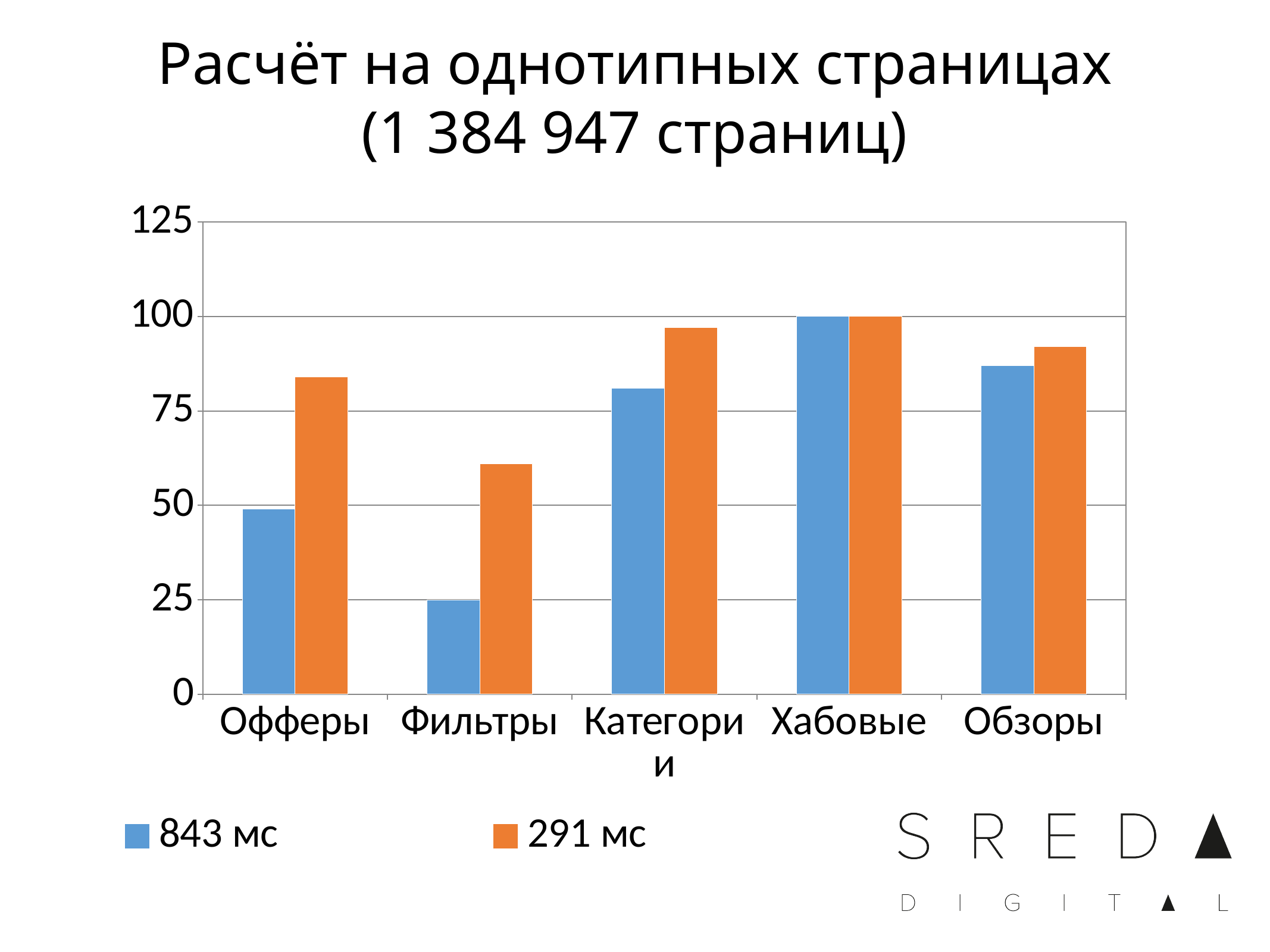
What kind of chart is shown on the slide? bar chart Is the value of the 291 мс series for Офферы greater or less than 75? greater How many series does the legend list? 2 What is the value of the 843 мс series for Хабовые? 100 Which category has the lowest value in the 843 мс series? Фильтры For Офферы, which series has the larger value, 843 мс or 291 мс? 291 мс Which category has the highest value in the 843 мс series? Хабовые What is the value of the 291 мс series for Хабовые? 100 What is the title of the chart slide? Расчёт на однотипных страницах (1 384 947 страниц) How many categories are shown on the x axis? 5 Which category has the lowest value in the 291 мс series? Фильтры Is the value of the 843 мс series for Категории greater or less than 75? greater